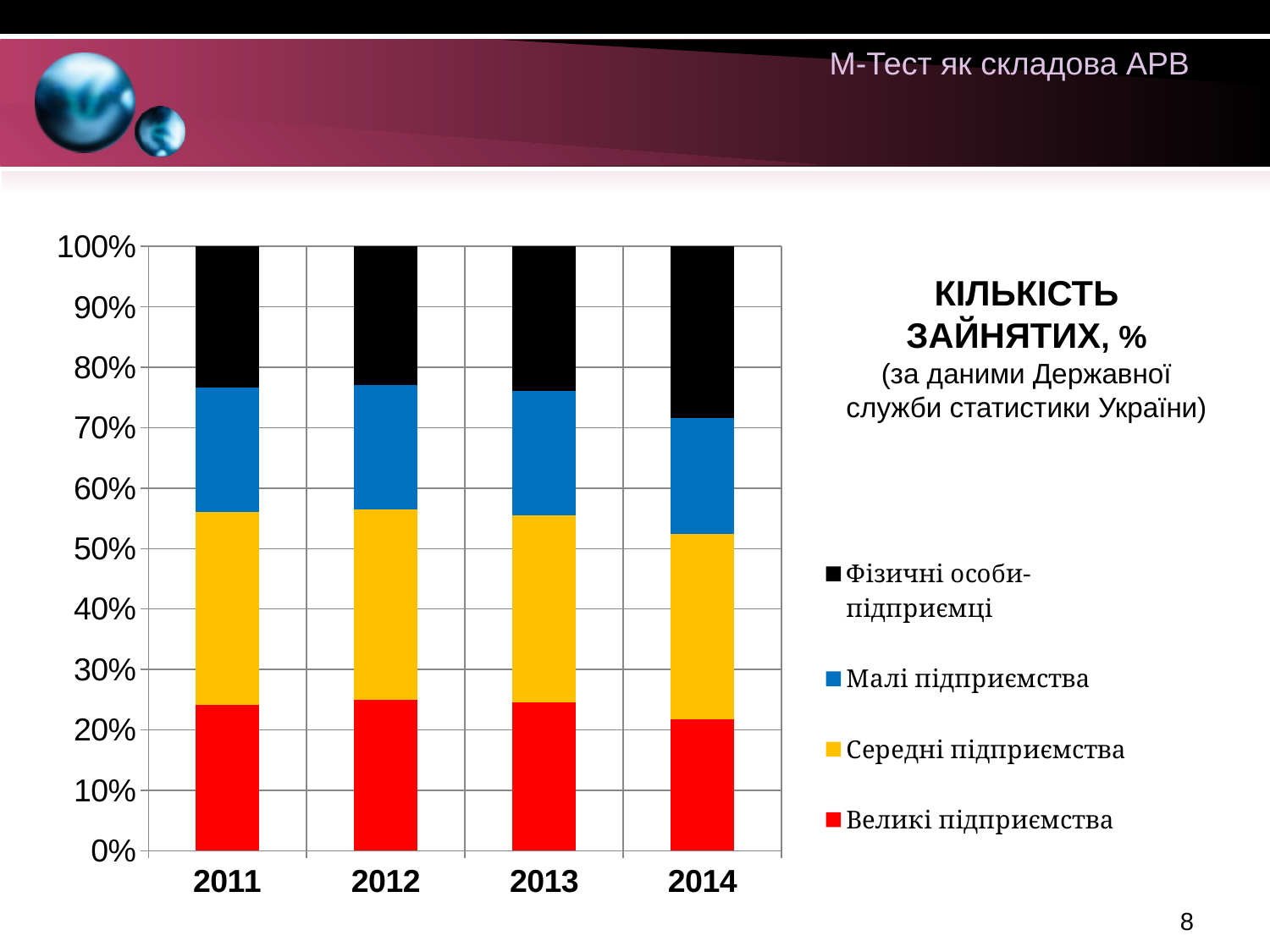
Which year has a larger share of Великі підприємства, 2012 or 2014? 2012 Is the share of Великі підприємства in 2012 greater or less than 20%? greater Which legend entry is shown in red? Великі підприємства In which year is the share of Великі підприємства the smallest? 2014 In which year is the share of Фізичні особи-підприємці the largest? 2014 What is the title of the chart? КІЛЬКІСТЬ ЗАЙНЯТИХ, % What kind of chart is shown on the slide? Stacked bar chart How many series does the chart legend list? 4 How many years are shown on the x axis of the chart? 4 Is the share of Великі підприємства in 2014 greater or less than 30%? less What is the highest value shown on the y axis? 100% Which year has a larger share of Фізичні особи-підприємці, 2011 or 2014? 2014